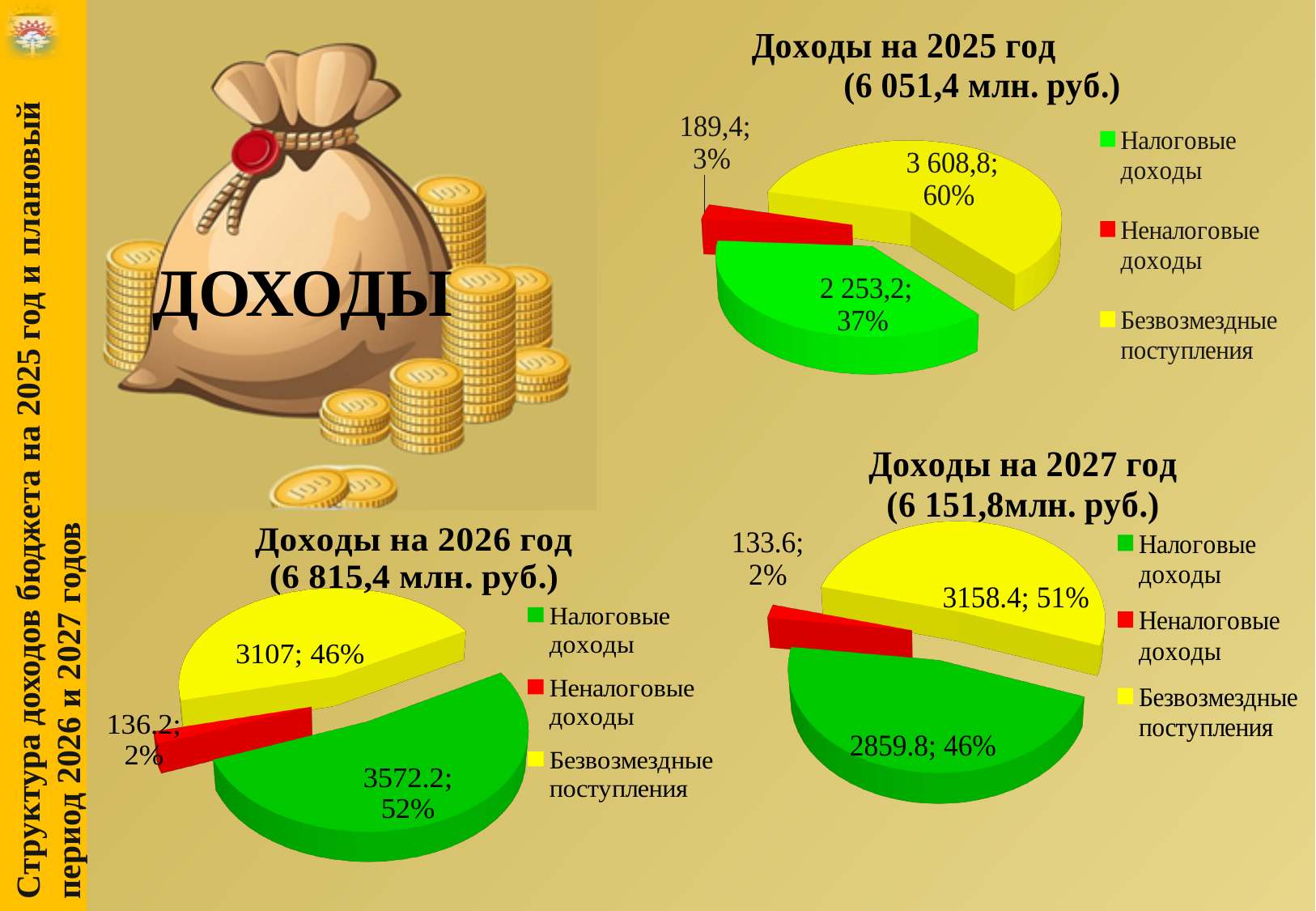
In the chart 'Доходы на 2025 год', what share of the pie is Безвозмездные поступления? 60% In the chart 'Доходы на 2027 год', what share of the pie is Налоговые доходы? 46% In the chart 'Доходы на 2026 год', what value is shown for Неналоговые доходы? 136.2 In the chart 'Доходы на 2027 год', which is larger: Налоговые доходы or Безвозмездные поступления? Безвозмездные поступления In the chart 'Доходы на 2027 год', what value is shown for Безвозмездные поступления? 3158.4 In the chart 'Доходы на 2026 год', which category has the largest slice? Налоговые доходы In the chart 'Доходы на 2026 год', what share of the pie is Безвозмездные поступления? 46% In the chart 'Доходы на 2025 год', which category has the smallest slice? Неналоговые доходы In the chart 'Доходы на 2025 год', what value is shown for Налоговые доходы? 2 253,2 What total is given in the title of the chart 'Доходы на 2027 год'? 6 151,8млн. руб. How many categories does the legend of the chart 'Доходы на 2025 год' list? 3 What kind of chart is 'Доходы на 2026 год'? Pie chart